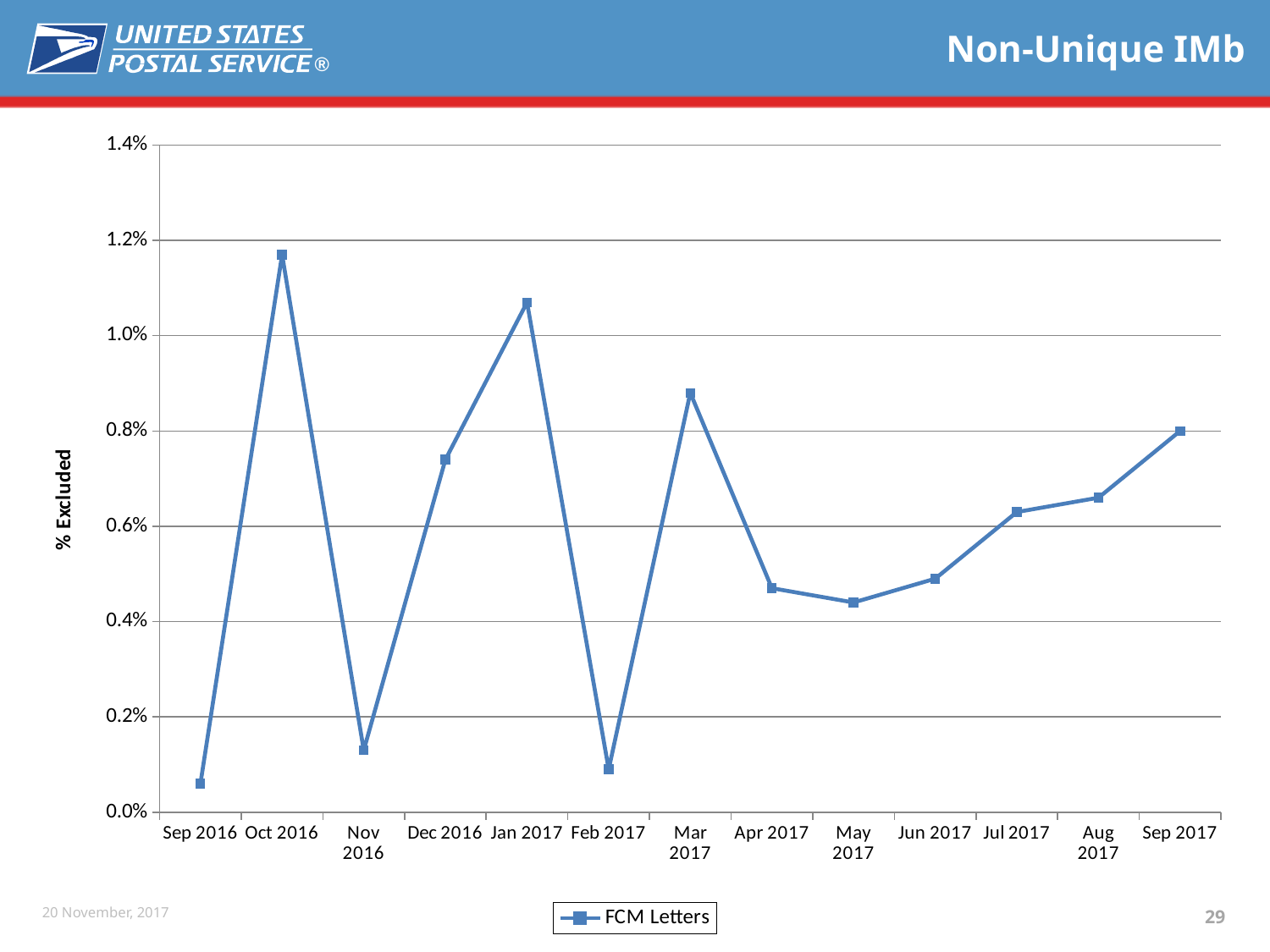
Is the value for Mar 2017 greater or less than 0.8%? greater What series name is shown in the legend? FCM Letters Is the value for Oct 2016 greater or less than 1.0%? greater Which is larger, the value for Oct 2016 or the value for Jan 2017? Oct 2016 What kind of chart is shown on the slide? Line chart How many series does the legend list? 1 Is the value for Nov 2016 greater or less than 0.2%? less Which is larger, the value for Dec 2016 or the value for Mar 2017? Mar 2017 How many months are plotted along the x axis? 13 Which month has the highest % Excluded value? Oct 2016 Do the values rise or fall from Jun 2017 to Sep 2017? Rise